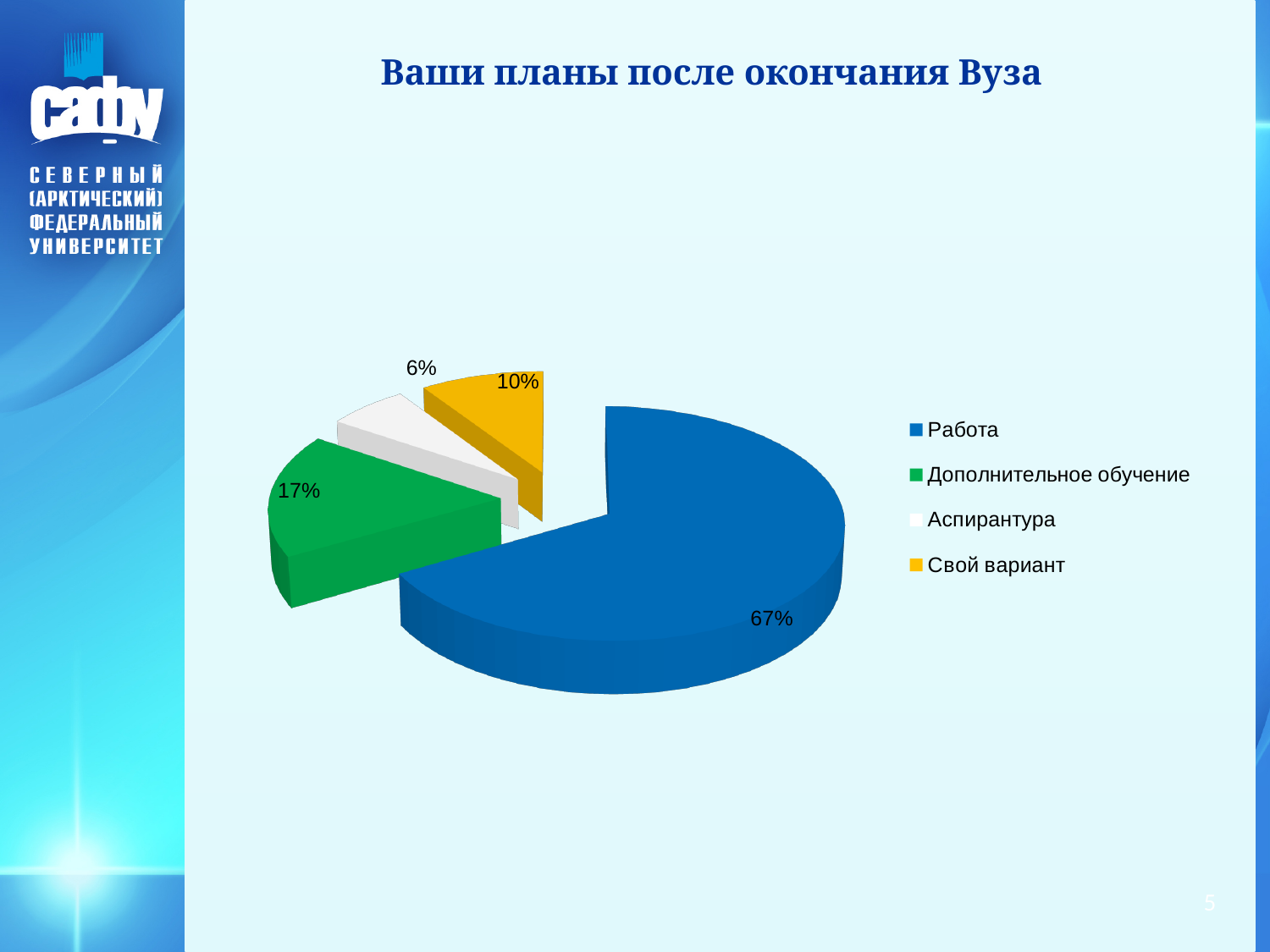
What kind of chart is shown on the slide? Pie chart What is the value for Дополнительное обучение? 17% What colour is the slice for Дополнительное обучение? Green What is the title of the slide's chart? Ваши планы после окончания Вуза What is the value for Свой вариант? 10% What is the difference between the shares for Работа and Дополнительное обучение? 50% What share of the pie does Работа account for? 67% Which category has the smallest slice? Аспирантура How many categories does the pie chart show? 4 Which is larger, the share for Свой вариант or the share for Аспирантура? Свой вариант What is the value for Аспирантура? 6% Which category has the largest slice? Работа